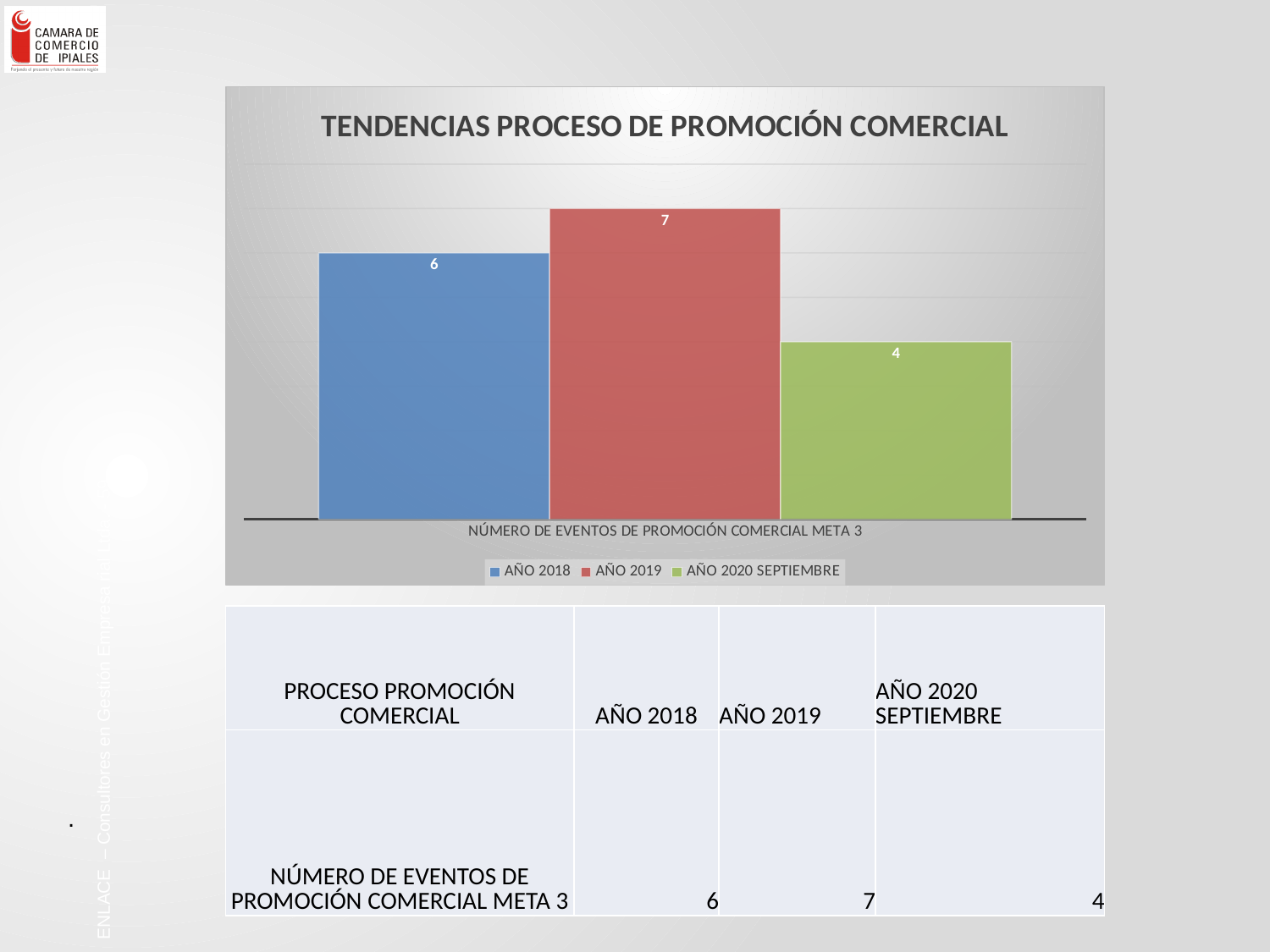
What kind of chart is shown on the slide? bar chart Which series has the highest value in the chart? AÑO 2019 How many series does the legend list? 3 What is the value for AÑO 2019 in the chart? 7 Which is larger, the value for AÑO 2018 or the value for AÑO 2020 SEPTIEMBRE? AÑO 2018 What is the value for AÑO 2018 in the chart? 6 What is the difference between the values for AÑO 2019 and AÑO 2018? 1 What is the category label shown on the x axis of the chart? NÚMERO DE EVENTOS DE PROMOCIÓN COMERCIAL META 3 Which series has the lowest value in the chart? AÑO 2020 SEPTIEMBRE What is the difference between the values for AÑO 2019 and AÑO 2020 SEPTIEMBRE? 3 What is the value for AÑO 2020 SEPTIEMBRE in the chart? 4 What is the title of the chart? TENDENCIAS PROCESO DE PROMOCIÓN COMERCIAL